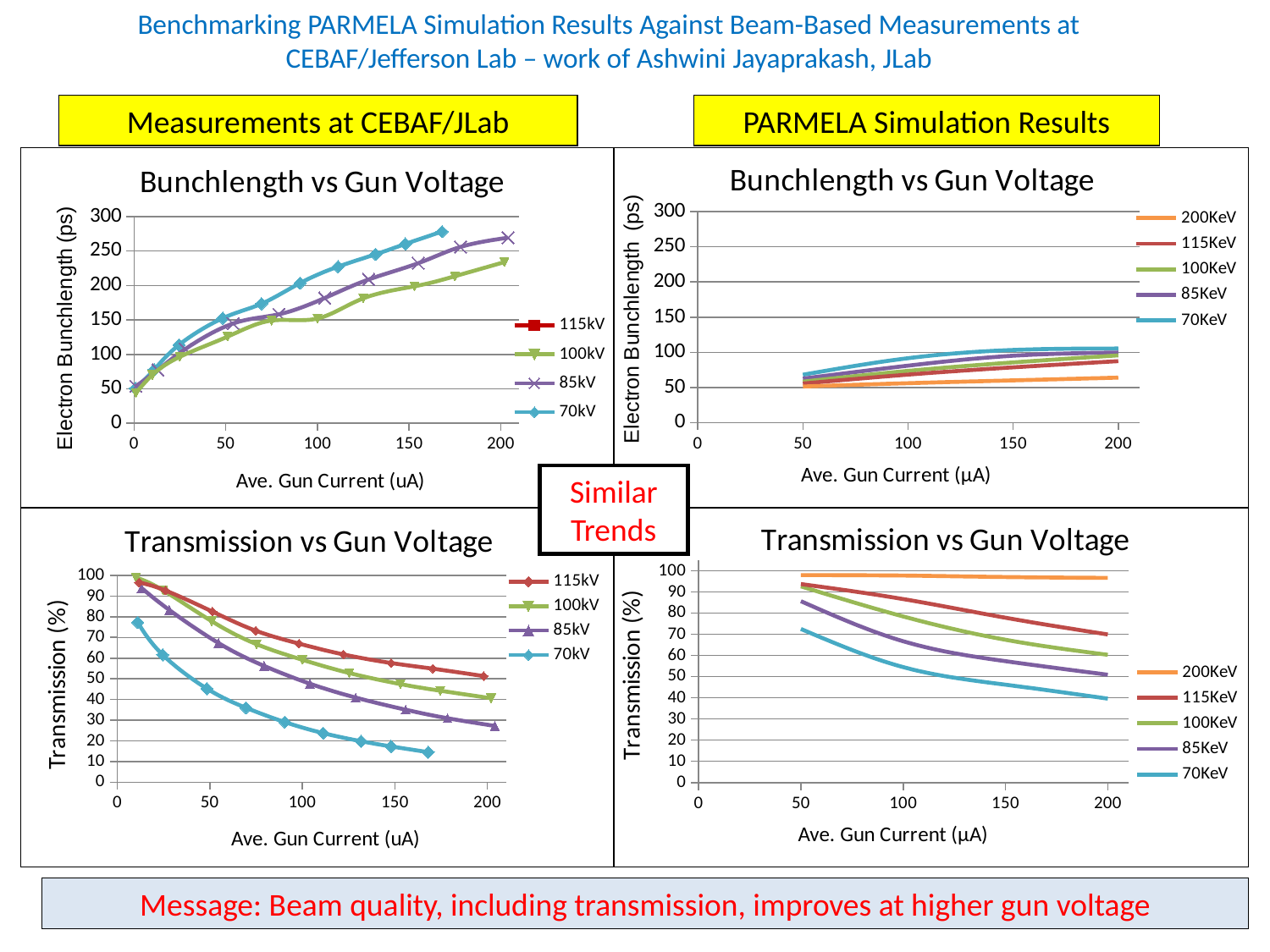
In the bottom-right 'Transmission vs Gun Voltage' PARMELA chart, is the transmission for 200KeV at 200 µA greater or less than 90? greater In the bottom-right 'Transmission vs Gun Voltage' PARMELA chart, which series has the highest transmission at 200 µA? 200KeV In the bottom-right 'Transmission vs Gun Voltage' PARMELA chart, does transmission rise or fall as the average gun current increases? fall How many series does the legend list in the top-right 'Bunchlength vs Gun Voltage' chart under PARMELA Simulation Results? 5 In the top-left 'Bunchlength vs Gun Voltage' measurement chart, is the bunchlength for 100kV at 200 uA greater or less than 250? less In the top-right 'Bunchlength vs Gun Voltage' PARMELA chart, is the bunchlength for 200KeV at 200 µA greater or less than 100? less In the top-left 'Bunchlength vs Gun Voltage' measurement chart, does the electron bunchlength rise or fall as the average gun current increases? rise What is the y-axis label of the bottom-left 'Transmission vs Gun Voltage' chart? Transmission (%) How many series does the legend list in the bottom-left 'Transmission vs Gun Voltage' chart under Measurements at CEBAF/JLab? 4 In the bottom-left 'Transmission vs Gun Voltage' measurement chart, which series has the lowest transmission at 50 uA, 115kV or 70kV? 70kV What type of chart is the top-left 'Bunchlength vs Gun Voltage' chart under Measurements at CEBAF/JLab? line chart